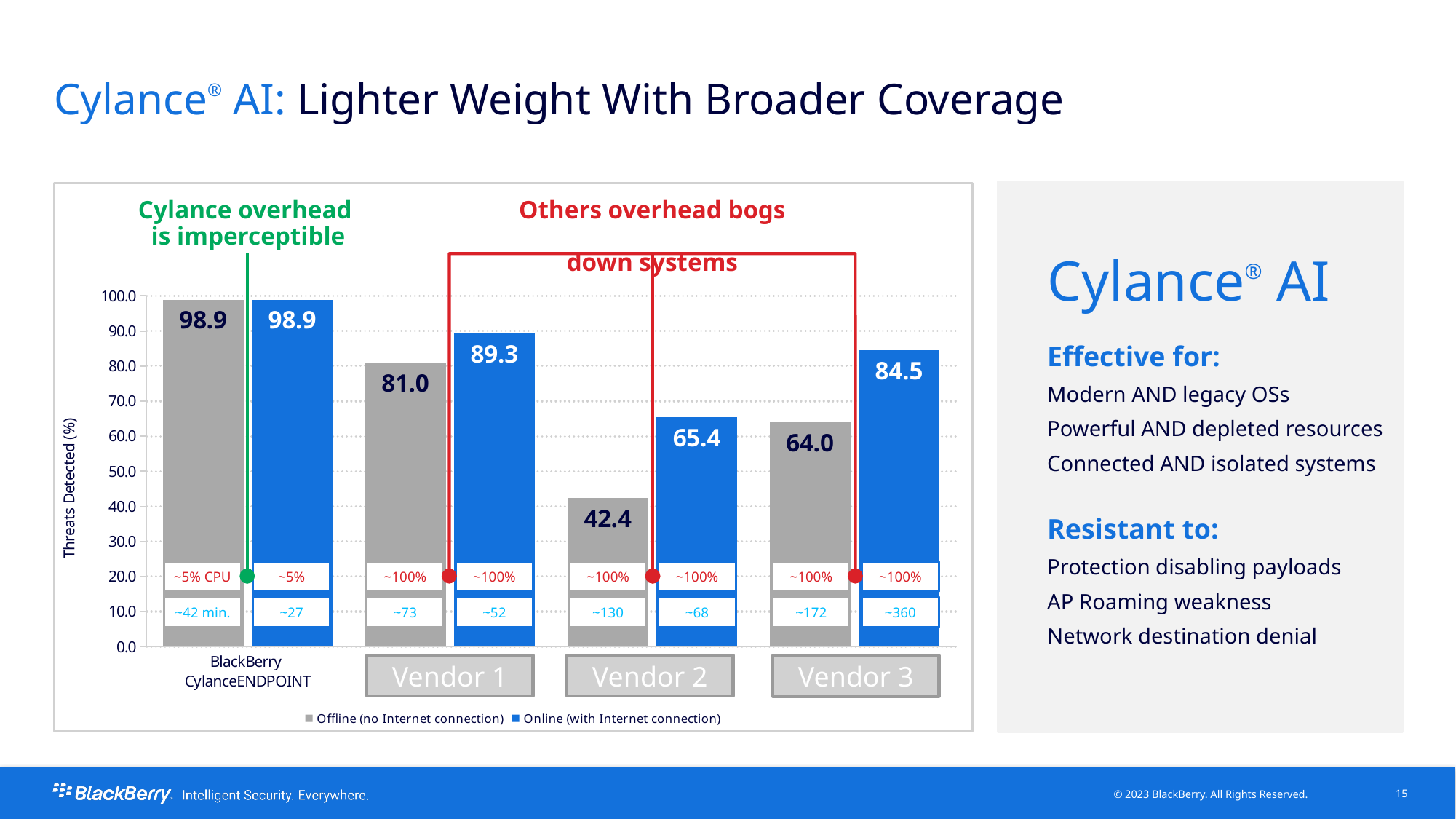
What is the Online (with Internet connection) value for Vendor 3? 84.5 Which category has the lowest Offline (no Internet connection) value? Vendor 2 Which is larger: the Online value for Vendor 1 or the Online value for Vendor 3? Vendor 1 How many series does the chart legend list? 2 What is the Online (with Internet connection) threats detected value for Vendor 2? 65.4 Is the Offline value for Vendor 3 greater or less than 70.0? less How many vendor categories are shown on the x axis of the chart? 4 What type of chart is shown on the slide? Bar chart Which category has the highest Online (with Internet connection) value? BlackBerry CylanceENDPOINT What is the Offline (no Internet connection) threats detected value for Vendor 1? 81.0 What is the difference between the Offline values for BlackBerry CylanceENDPOINT and Vendor 3? 34.9 What is the difference between the Online and Offline values for Vendor 2? 23.0